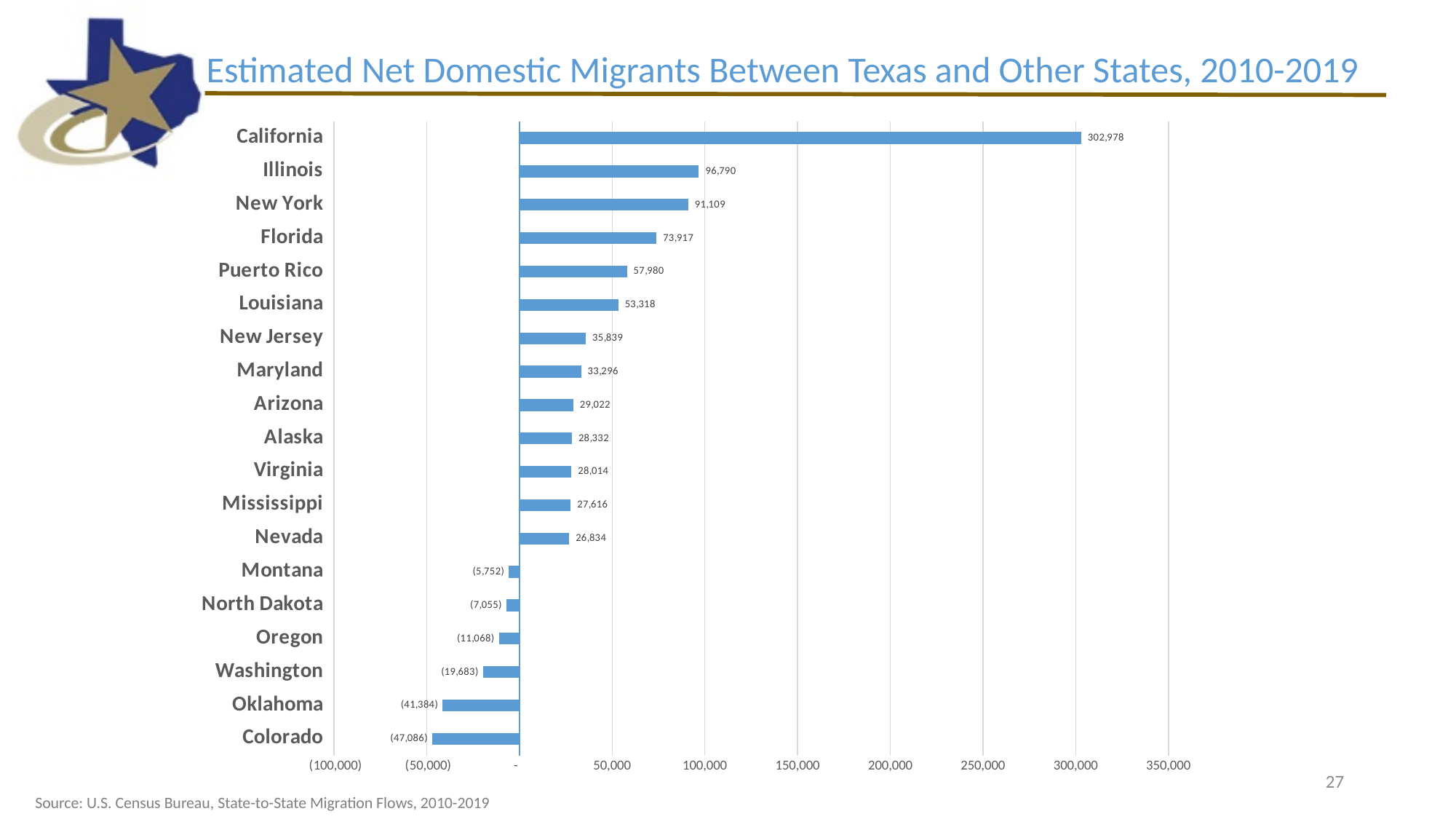
What is the title of the chart? Estimated Net Domestic Migrants Between Texas and Other States, 2010-2019 What is the value for California? 302,978 What is the value for Puerto Rico? 57,980 What is the difference between the values for Illinois and New York? 5,681 Which category has the lowest value? Colorado What is the difference between the values for Florida and Puerto Rico? 15,937 How many categories are shown in the chart? 19 Which category has the highest value? California Which is larger, the value for Louisiana or the value for New Jersey? Louisiana What kind of chart is shown on the slide? Bar chart What is the value for Colorado? (47,086) What is the value for Washington? (19,683)